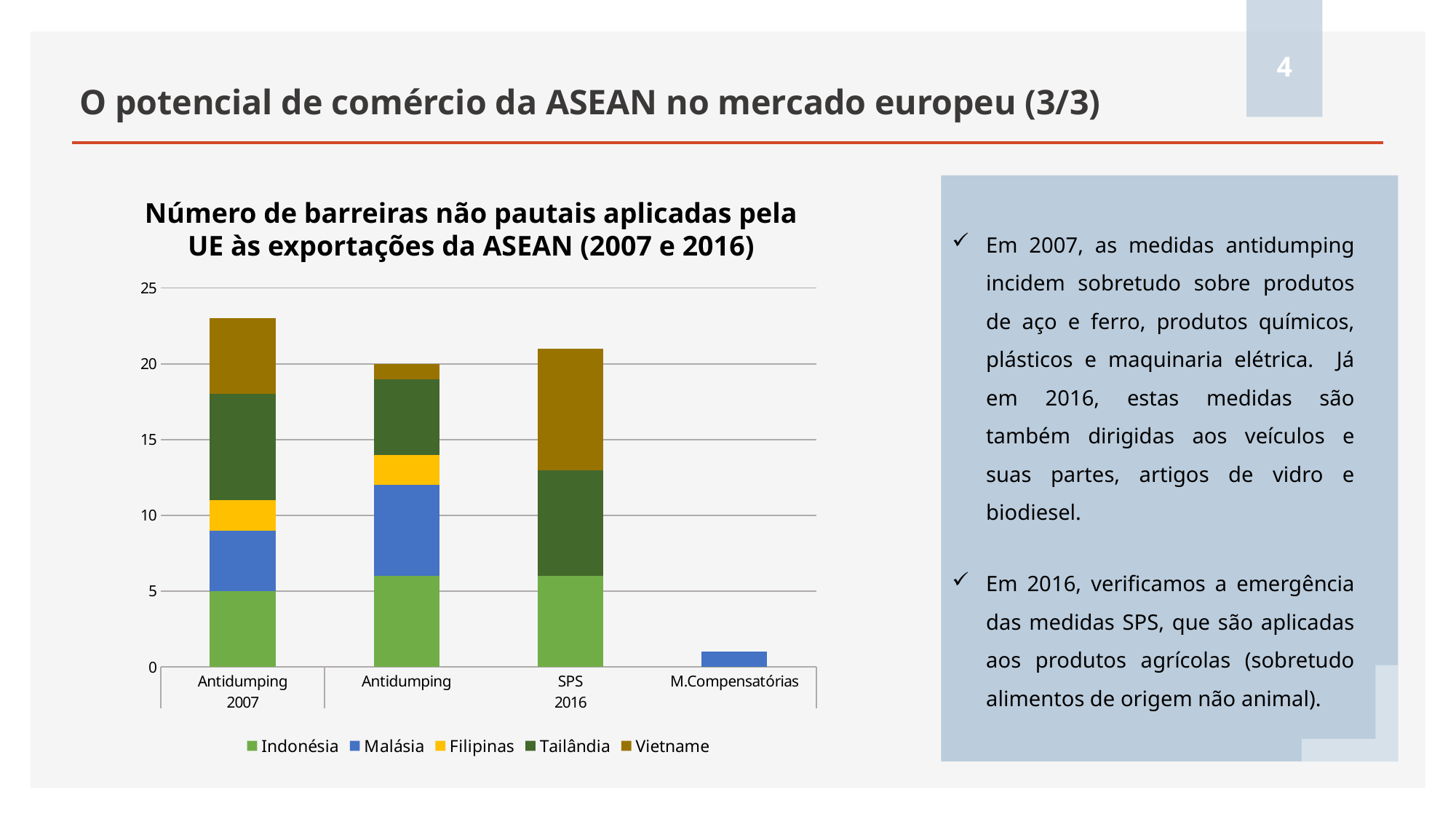
How many series does the legend list? 5 Is the total for Antidumping 2007 greater or less than 20? greater Is the total for M.Compensatórias greater or less than 5? less How many bars (categories) are plotted in the chart? 4 Which stacked bar is taller: SPS (2016) or M.Compensatórias? SPS Which category has the tallest stacked bar? Antidumping 2007 Is the total for SPS (2016) greater or less than 15? greater Which stacked bar is taller: Antidumping 2007 or Antidumping 2016? Antidumping 2007 Which category has the shortest stacked bar? M.Compensatórias What kind of chart is shown on the slide? Stacked bar chart What is the title of the chart? Número de barreiras não pautais aplicadas pela UE às exportações da ASEAN (2007 e 2016) Which series is shown in yellow in the legend? Filipinas